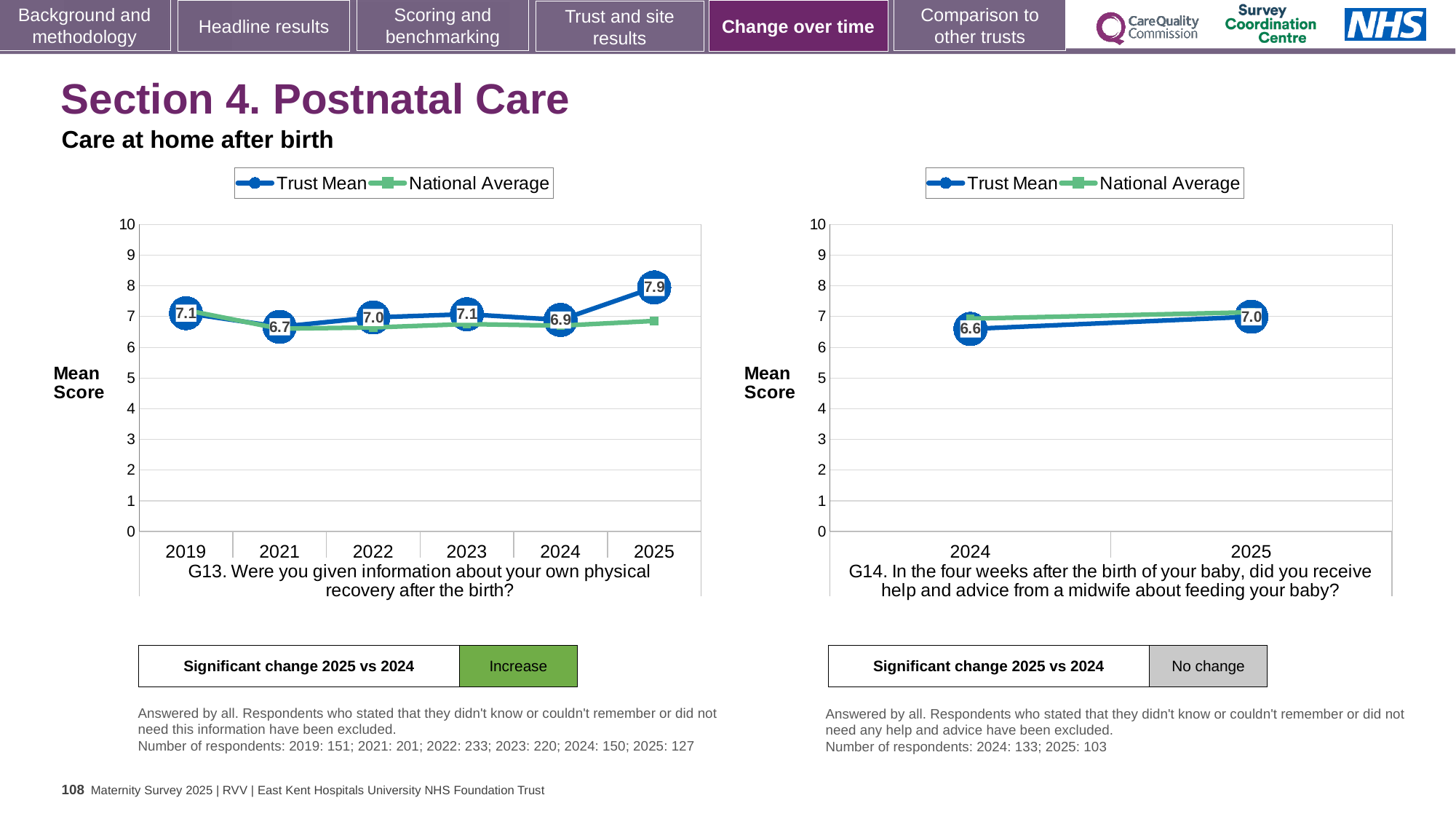
How many series does the legend of the G13 chart on the left list? 2 In the G13 chart on the left, what is the difference between the Trust Mean scores for 2025 and 2024? 1.0 In the G13 chart on the left, what is the Trust Mean score for 2021? 6.7 In the G13 chart on the left, what is the Trust Mean score for 2025? 7.9 In the G13 chart on the left, which year has the lowest Trust Mean score? 2021 In the G14 chart on the right, what is the Trust Mean score for 2025? 7.0 In the G13 chart on the left, which year has the highest Trust Mean score? 2025 What kind of chart is the G14 chart on the right? line chart In the G14 chart on the right, does the Trust Mean rise or fall from 2024 to 2025? rise In the G14 chart on the right, what is the Trust Mean score for 2024? 6.6 In the G13 chart on the left, how many years are plotted on the x axis? 6 In the G14 chart on the right, is the Trust Mean score for 2024 greater or less than 7? less